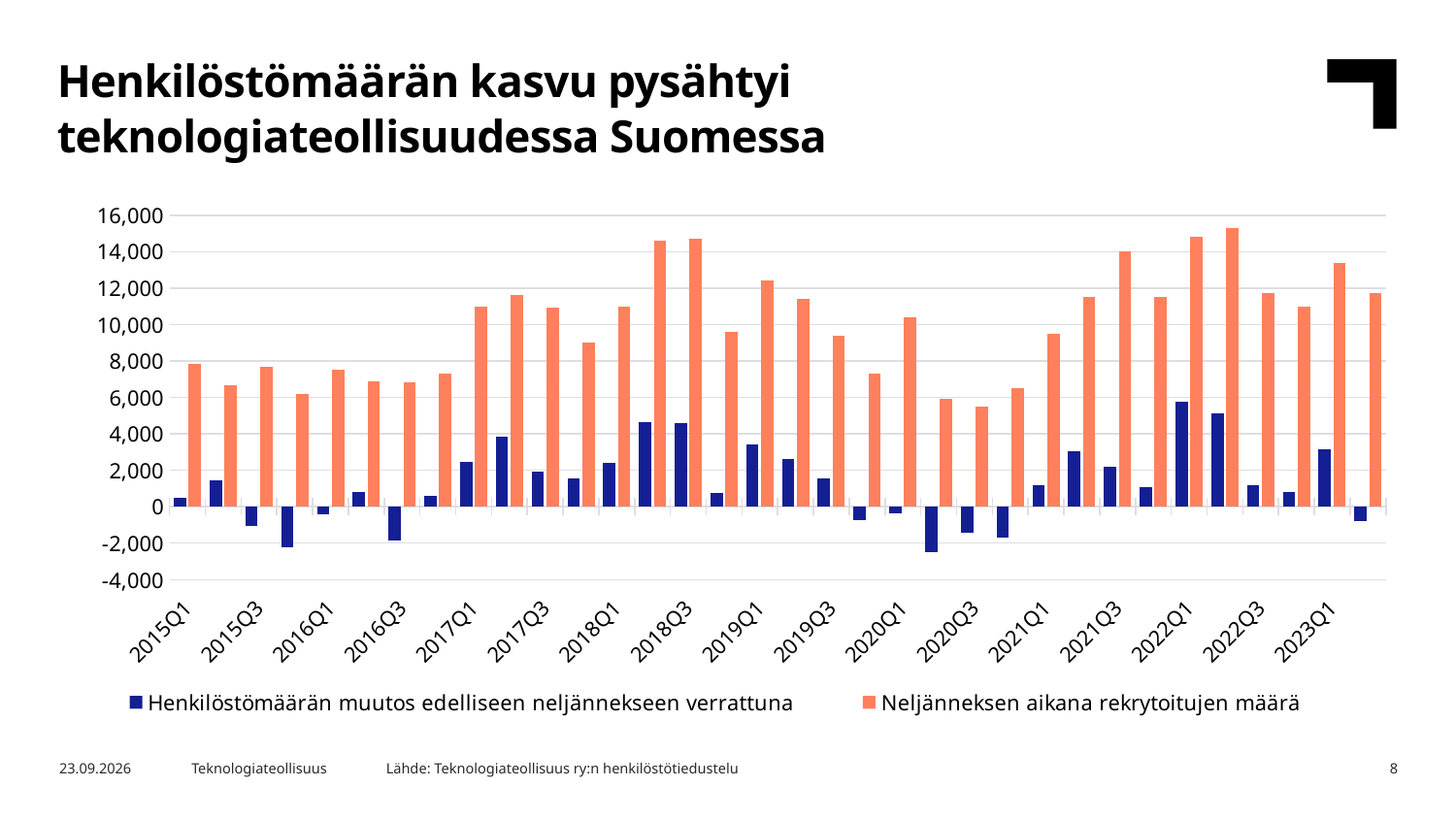
Is the value of Henkilöstömäärän muutos edelliseen neljännekseen verrattuna for 2015Q3 greater or less than 0? less Does the value of Neljänneksen aikana rekrytoitujen määrä generally rise or fall from 2015Q1 to 2018Q3? rise Is the value of Neljänneksen aikana rekrytoitujen määrä for 2015Q1 greater or less than 6,000? greater Is the value of Henkilöstömäärän muutos edelliseen neljännekseen verrattuna for 2022Q1 greater or less than 4,000? greater What is the title of the slide containing the chart? Henkilöstömäärän kasvu pysähtyi teknologiateollisuudessa Suomessa Which is larger for Neljänneksen aikana rekrytoitujen määrä: the value for 2018Q3 or the value for 2015Q1? 2018Q3 What kind of chart is shown on the slide? bar chart How many series does the chart legend list? 2 Which series is shown in orange in the chart? Neljänneksen aikana rekrytoitujen määrä Which is larger for Henkilöstömäärän muutos edelliseen neljännekseen verrattuna: the value for 2022Q1 or the value for 2017Q1? 2022Q1